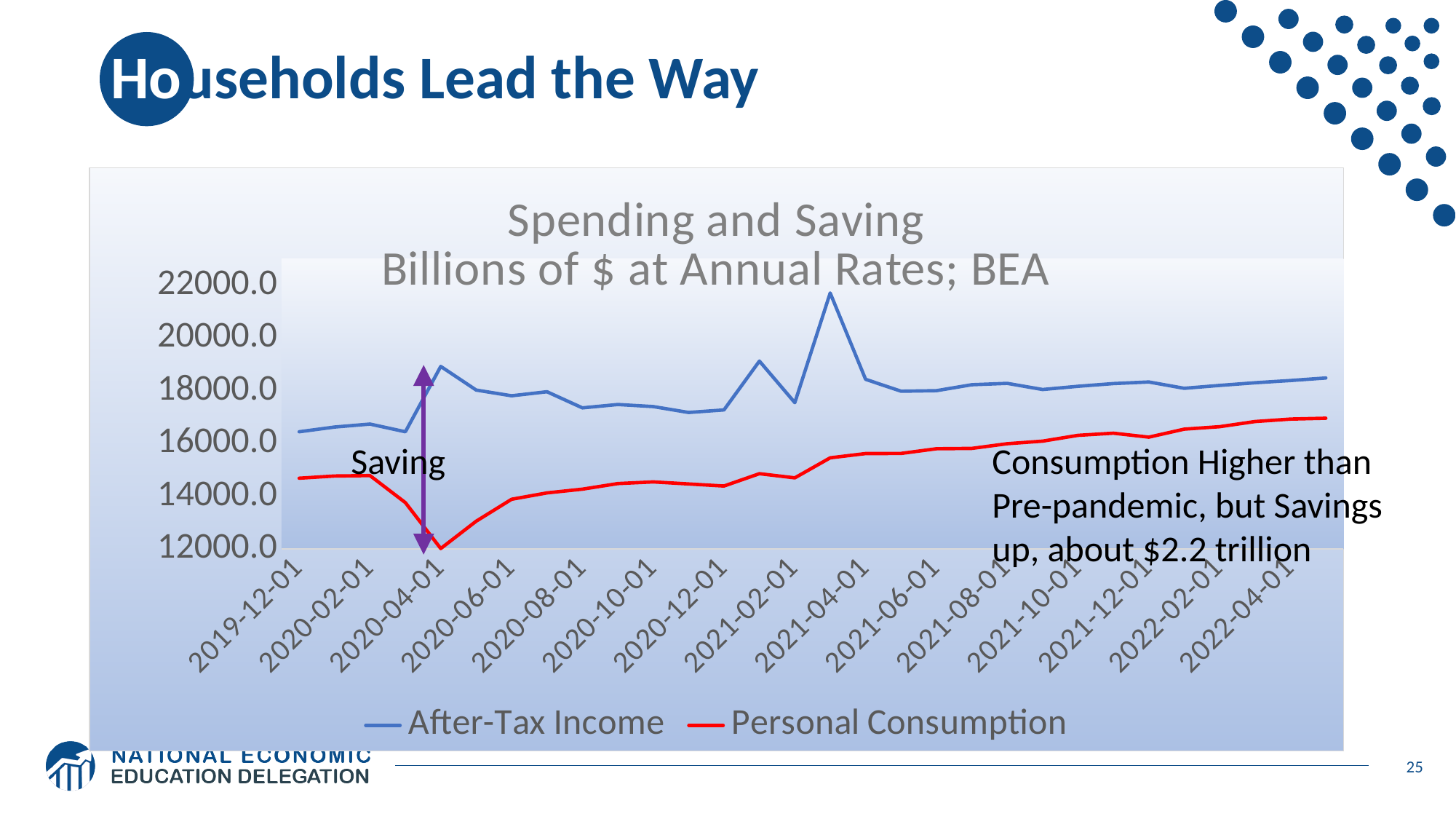
Is the Personal Consumption value at 2020-04-01 greater or less than 14000? less Does the Personal Consumption line generally rise or fall from 2020-06-01 to 2022-04-01? rise What kind of chart is shown on the slide? line chart How many series does the legend of the chart list? 2 Is the Personal Consumption value at 2022-04-01 greater or less than 16000? greater At which date does the Personal Consumption line reach its lowest point? 2020-04-01 What are the two series named in the chart legend? After-Tax Income and Personal Consumption Which series is higher at 2021-06-01, After-Tax Income or Personal Consumption? After-Tax Income What colour is the Personal Consumption line in the chart? red Is the After-Tax Income value at 2022-04-01 greater or less than 18000? greater